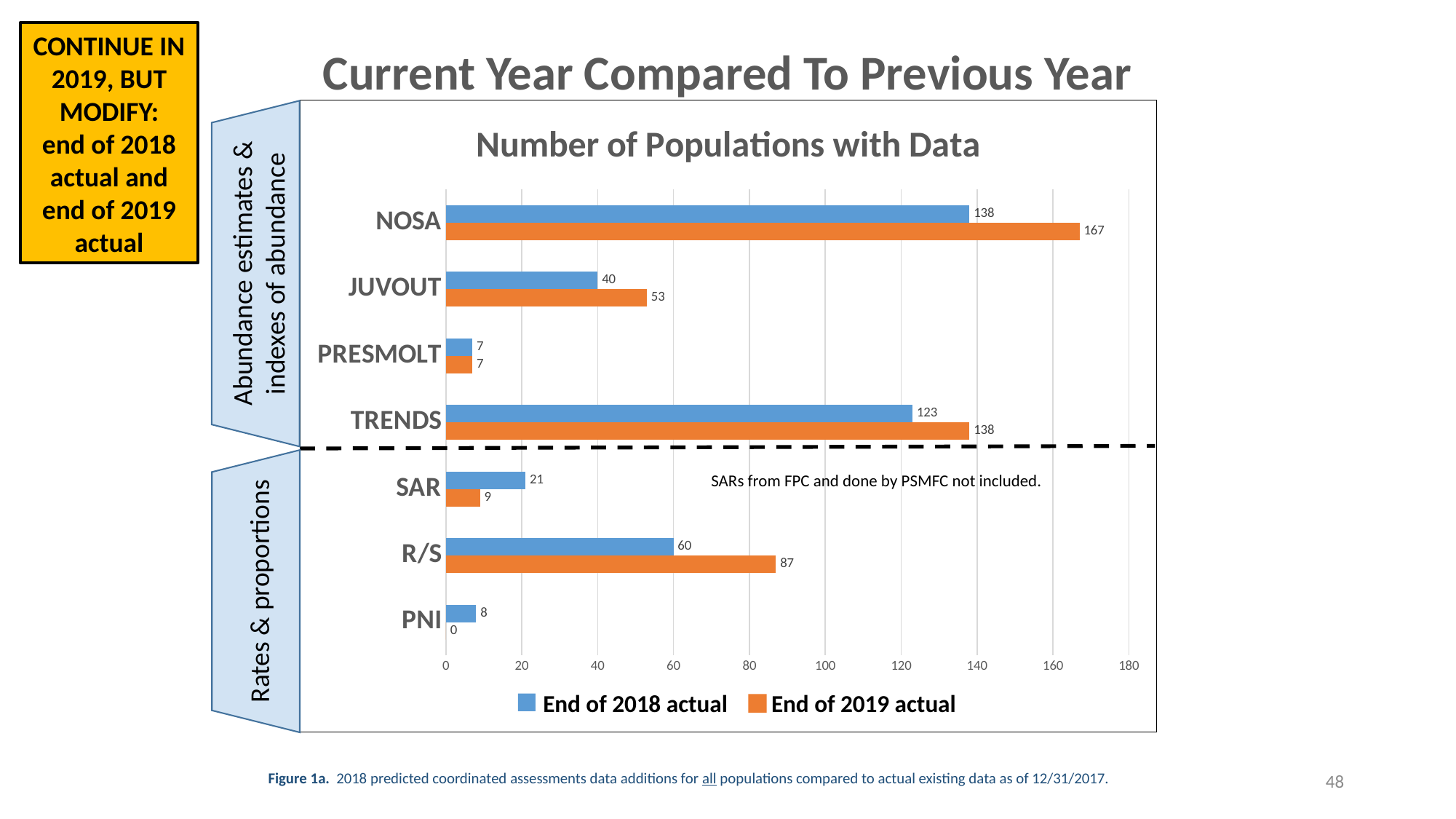
How many series does the legend list? 2 How many categories are shown on the chart? 7 What is the End of 2018 actual value for TRENDS? 123 What is the End of 2019 actual value for NOSA? 167 Which category has the highest End of 2019 actual value? NOSA What is the difference between the End of 2019 actual and End of 2018 actual values for JUVOUT? 13 What is the End of 2019 actual value for R/S? 87 What is the End of 2019 actual value for PNI? 0 What is the title of the chart? Number of Populations with Data Which category has the lowest End of 2018 actual value? PRESMOLT What kind of chart is shown on the slide? Bar chart For SAR, which is larger: the End of 2018 actual value or the End of 2019 actual value? End of 2018 actual